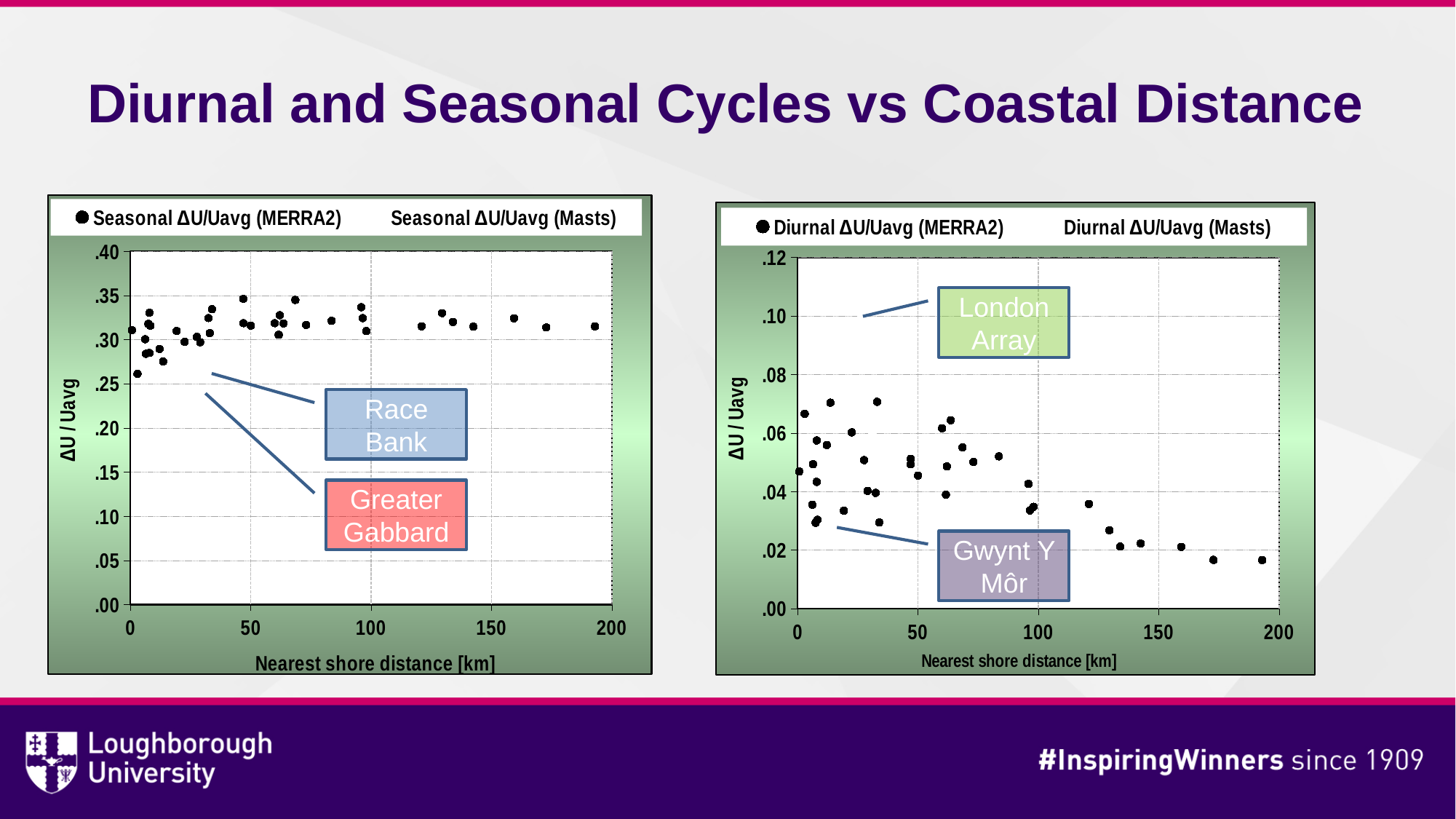
How many series does the legend of the left (Seasonal) chart list? 2 In the left (Seasonal) chart, is the value for the point at about 160 km greater or less than .25? greater In the right (Diurnal) chart, is the value for the point at about 193 km greater or less than .04? less In the right (Diurnal) chart, is the value for the point at about 120 km greater or less than .06? less What is the x-axis label of the left (Seasonal) chart? Nearest shore distance [km] Which two wind farms are labelled with callout boxes on the right (Diurnal) chart? London Array and Gwynt Y Môr How many series does the legend of the right (Diurnal) chart list? 2 In the right (Diurnal) chart, do the values generally rise or fall as nearest shore distance increases? Fall What kind of chart is the left chart, titled with the legend 'Seasonal ΔU/Uavg (MERRA2)'? Scatter chart What kind of chart is the right chart, titled with the legend 'Diurnal ΔU/Uavg (MERRA2)'? Scatter chart